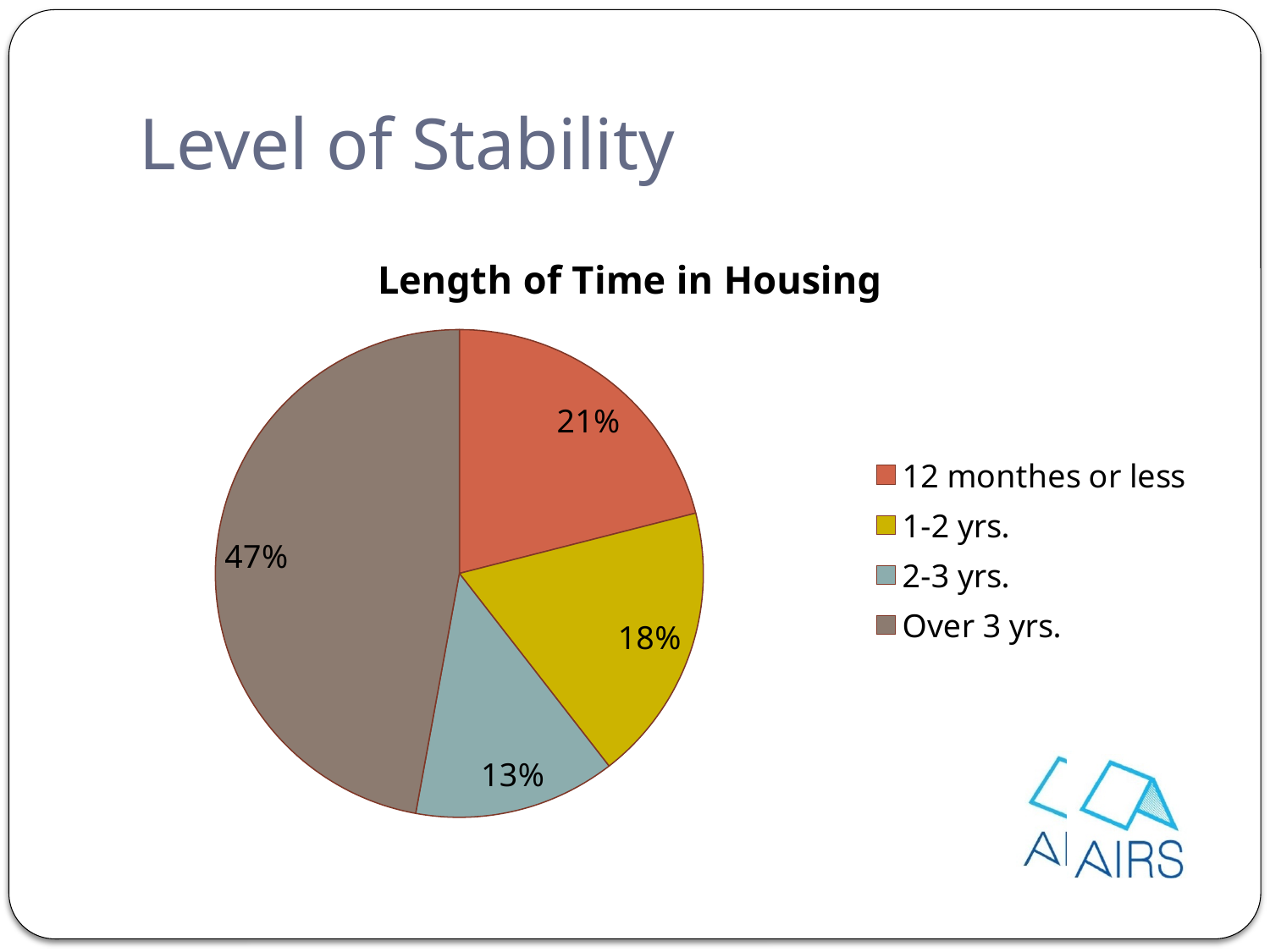
Which is larger, the share for '1-2 yrs.' or the share for '2-3 yrs.'? 1-2 yrs. What type of chart is shown on the slide? pie chart What is the title of the chart? Length of Time in Housing What percentage of the pie is for '1-2 yrs.'? 18% What percentage of the pie is for '2-3 yrs.'? 13% What percentage of the pie is for 'Over 3 yrs.'? 47% What percentage of the pie is for '12 monthes or less'? 21% What is the difference in percentage points between 'Over 3 yrs.' and '12 monthes or less'? 26 How many categories does the pie chart have? 4 Which category has the smallest share of the pie? 2-3 yrs. Which category has the largest share of the pie? Over 3 yrs. What colour is the slice for 'Over 3 yrs.'? brown/grey